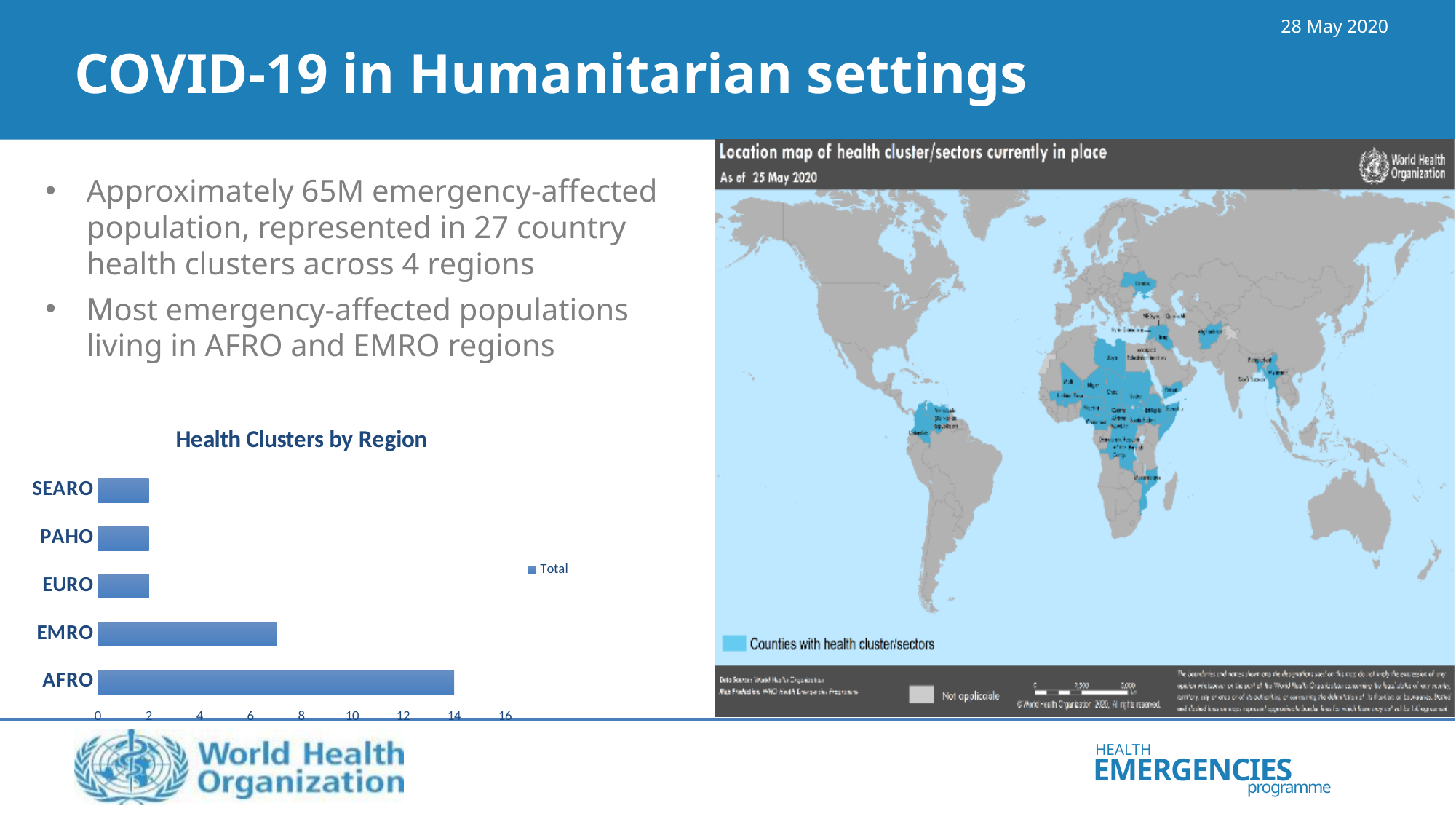
How many series does the legend of the "Health Clusters by Region" chart list? 1 What kind of chart is "Health Clusters by Region"? bar chart In the "Health Clusters by Region" chart, is the value for EMRO greater or less than 6? greater What is the value for EURO in the "Health Clusters by Region" chart? 2 What is the value for SEARO in the "Health Clusters by Region" chart? 2 What is the name of the series shown in the legend of the "Health Clusters by Region" chart? Total Which region has the highest value in the "Health Clusters by Region" chart? AFRO In the "Health Clusters by Region" chart, what is the difference between the values for AFRO and SEARO? 12 In the "Health Clusters by Region" chart, which is larger, the value for EMRO or the value for PAHO? EMRO What is the value for AFRO in the "Health Clusters by Region" chart? 14 How many regions are shown in the "Health Clusters by Region" chart? 5 In the "Health Clusters by Region" chart, is the value for EMRO greater or less than 8? less